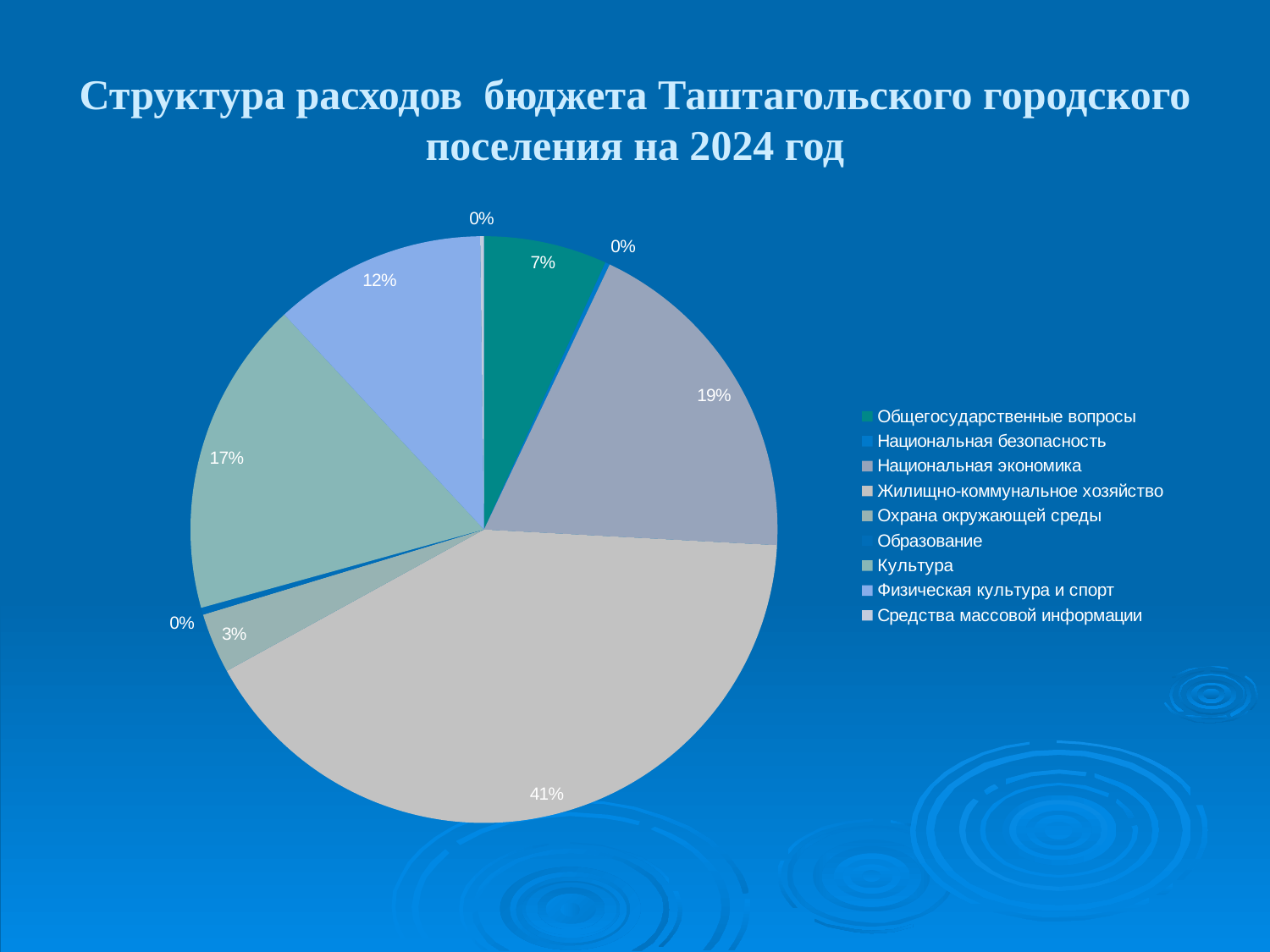
What share of the pie does Жилищно-коммунальное хозяйство represent? 41% What is the title of the slide? Структура расходов бюджета Таштагольского городского поселения на 2024 год How many categories does the legend list? 9 What percentage is shown for Общегосударственные вопросы? 7% What type of chart is shown on the slide? Pie chart Which category has the largest share of the pie? Жилищно-коммунальное хозяйство What percentage is shown for Охрана окружающей среды? 3% What percentage is shown for Физическая культура и спорт? 12% What percentage is shown for Культура? 17% Which is larger, the share for Культура or the share for Физическая культура и спорт? Культура What percentage is shown for Национальная экономика? 19% What is the difference in percentage points between Жилищно-коммунальное хозяйство and Национальная экономика? 22